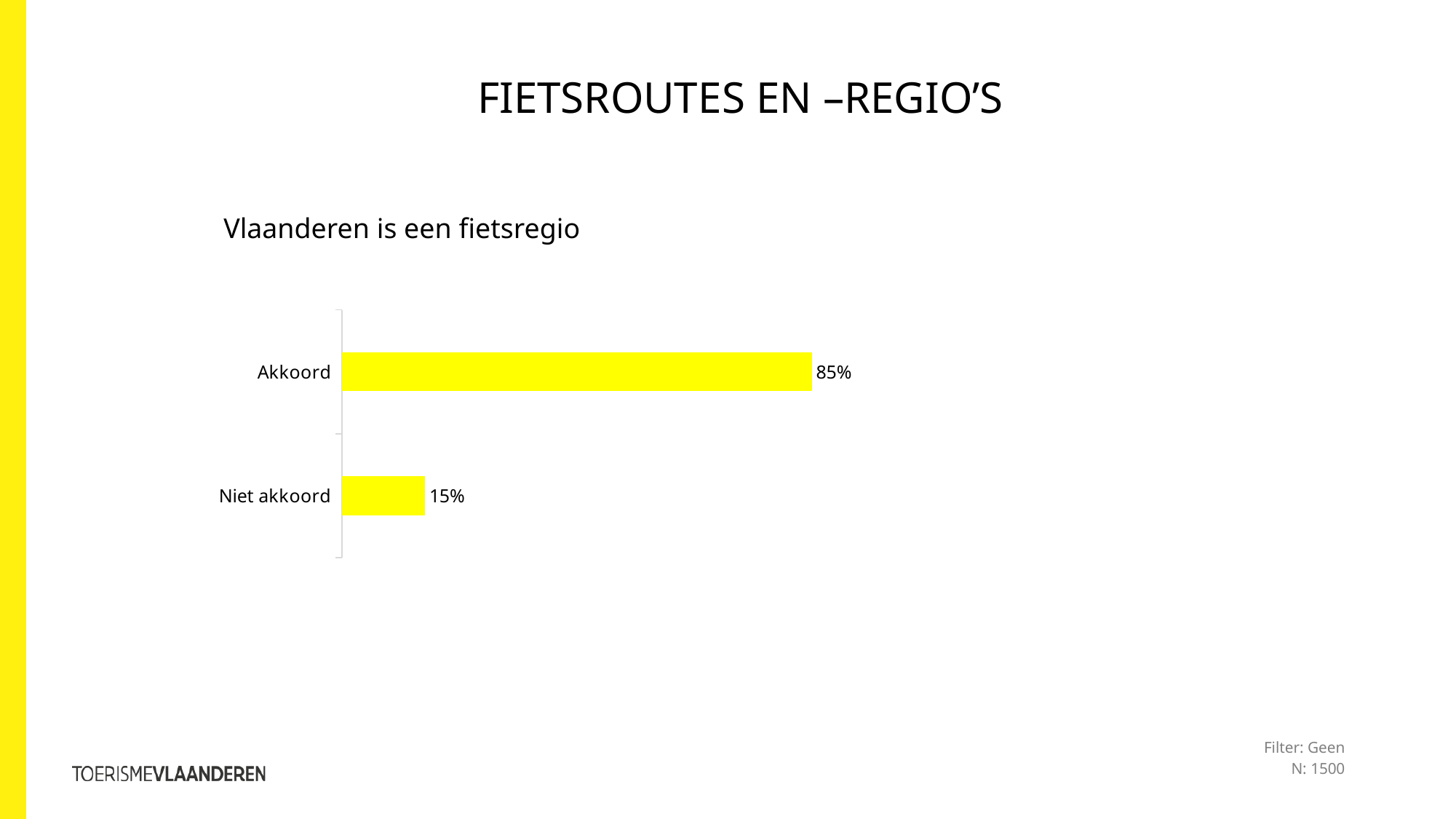
What is the title of the chart? Vlaanderen is een fietsregio How many categories are shown in the chart? 2 What colour are the bars in the chart? Yellow Which category has the highest value? Akkoord What is the difference between the values for Akkoord and Niet akkoord? 70% What is the total of the values for Akkoord and Niet akkoord? 100% What is the value for Akkoord? 85% Which category has the lowest value? Niet akkoord What is the value for Niet akkoord? 15% What kind of chart is shown on the slide? Bar chart Which is larger, the value for Akkoord or the value for Niet akkoord? Akkoord